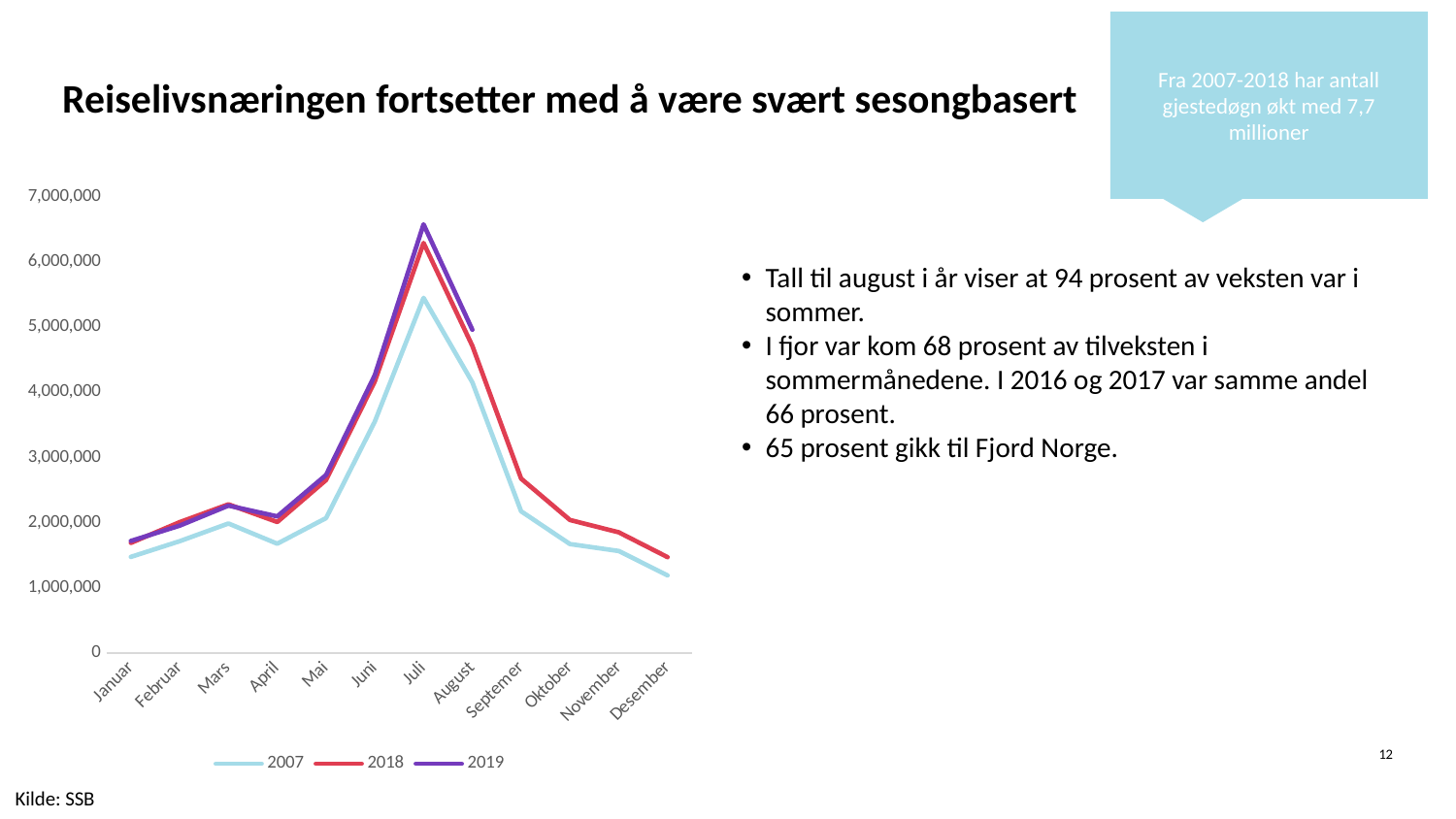
How many series does the chart legend list? 3 Which years are listed in the chart legend? 2007, 2018, 2019 What colour is the line for the 2019 series? purple Do the values of the 2018 series rise or fall from Juli to Desember? fall Is the value for Desember in the 2007 series greater or less than 2,000,000? less Which series has the higher value in Juli, 2007 or 2019? 2019 How many months are shown along the x axis of the chart? 12 Is the value for Juli in the 2007 series greater or less than 6,000,000? less In which month does the 2018 series reach its highest value? Juli In which month does the 2007 series reach its highest value? Juli What kind of chart is shown on the slide? line chart Is the value for Juli in the 2019 series greater or less than 6,000,000? greater